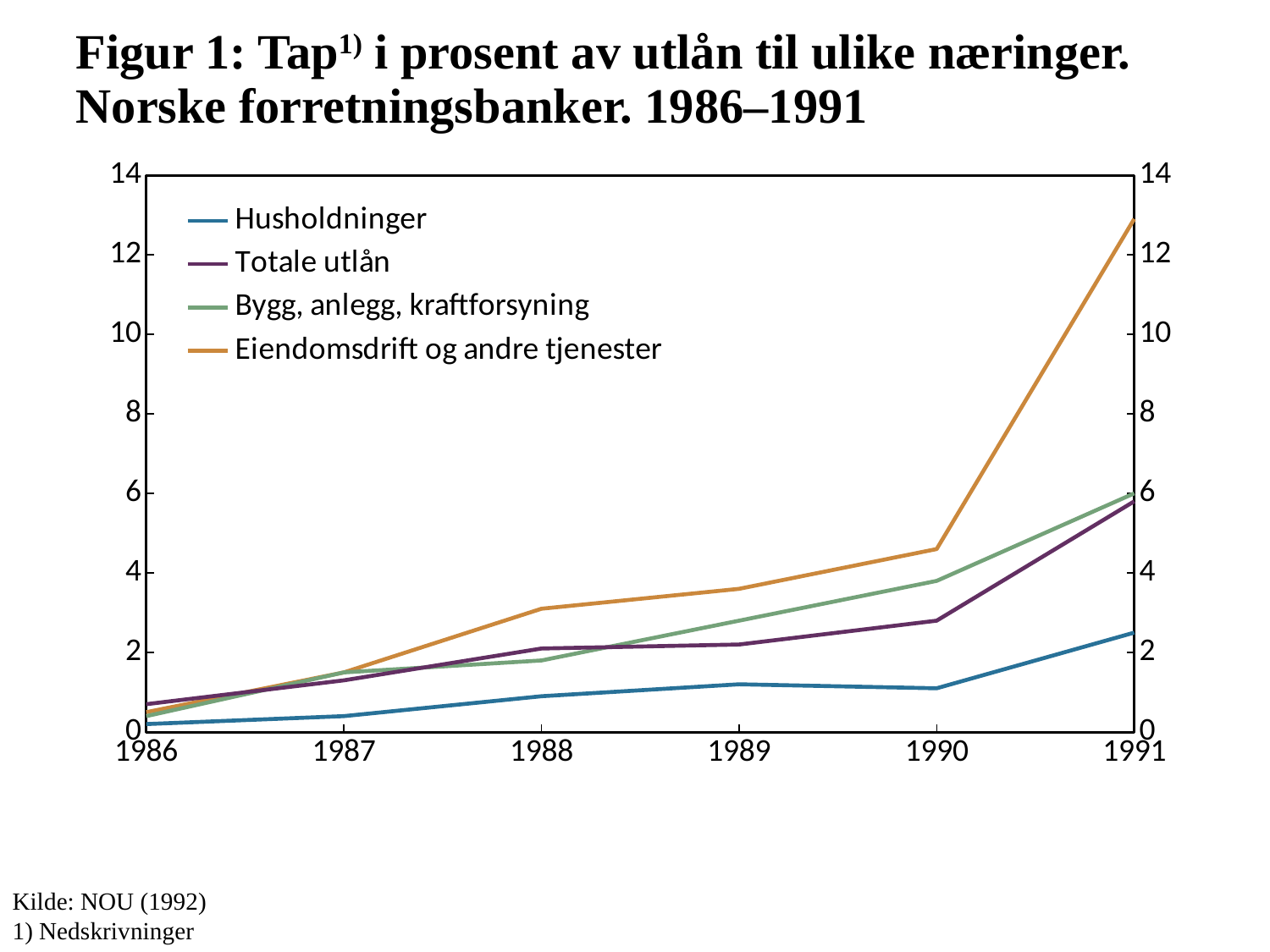
How many years are shown along the x axis? 6 Is the value for Bygg, anlegg, kraftforsyning in 1990 greater or less than 2? greater What kind of chart is shown on the slide? Line chart In 1990, which is larger: Eiendomsdrift og andre tjenester or Totale utlån? Eiendomsdrift og andre tjenester Is the value for Husholdninger in 1991 greater or less than 4? less What source is cited below the chart? NOU (1992) Which series has the highest value in 1991? Eiendomsdrift og andre tjenester Is the value for Totale utlån in 1988 greater or less than 4? less Which series has the lowest value in 1991? Husholdninger Does the Eiendomsdrift og andre tjenester line rise or fall from 1986 to 1991? Rises How many series does the legend list? 4